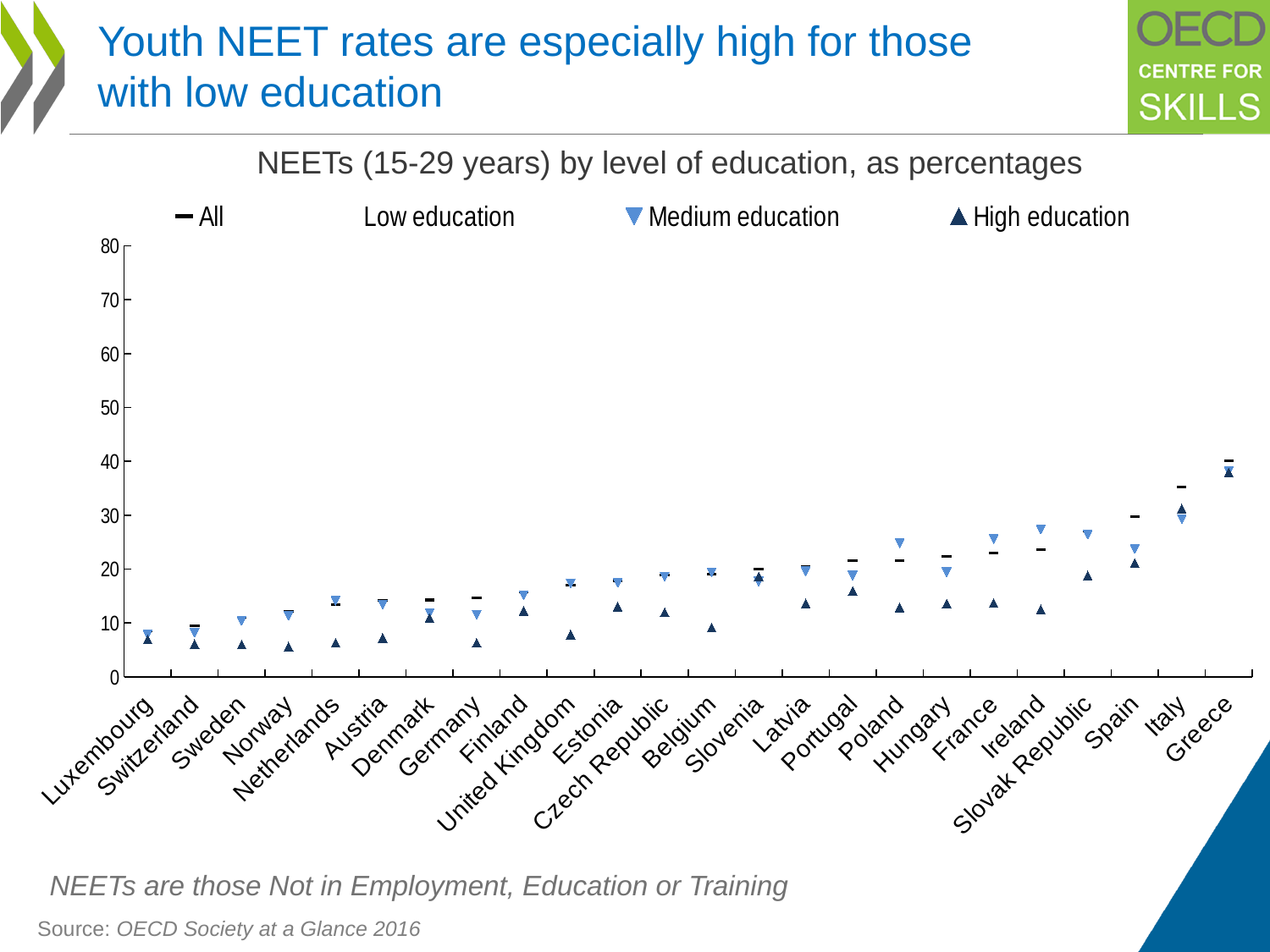
Which country has the highest value for Medium education? Greece Is the value for the All series in Italy greater or less than 30? greater Is the Medium education value for Ireland greater or less than 20? greater Which country has the highest value for the All series? Greece What is the title of the chart? NEETs (15-29 years) by level of education, as percentages Is the value for the All series in Luxembourg greater or less than 10? less How many countries are shown along the x axis? 24 What kind of chart is shown on the slide? scatter chart Do the values for the All series generally rise or fall from left to right along the x axis? rise Which is larger, the All value for Italy or the All value for Luxembourg? Italy How many series does the legend list? 4